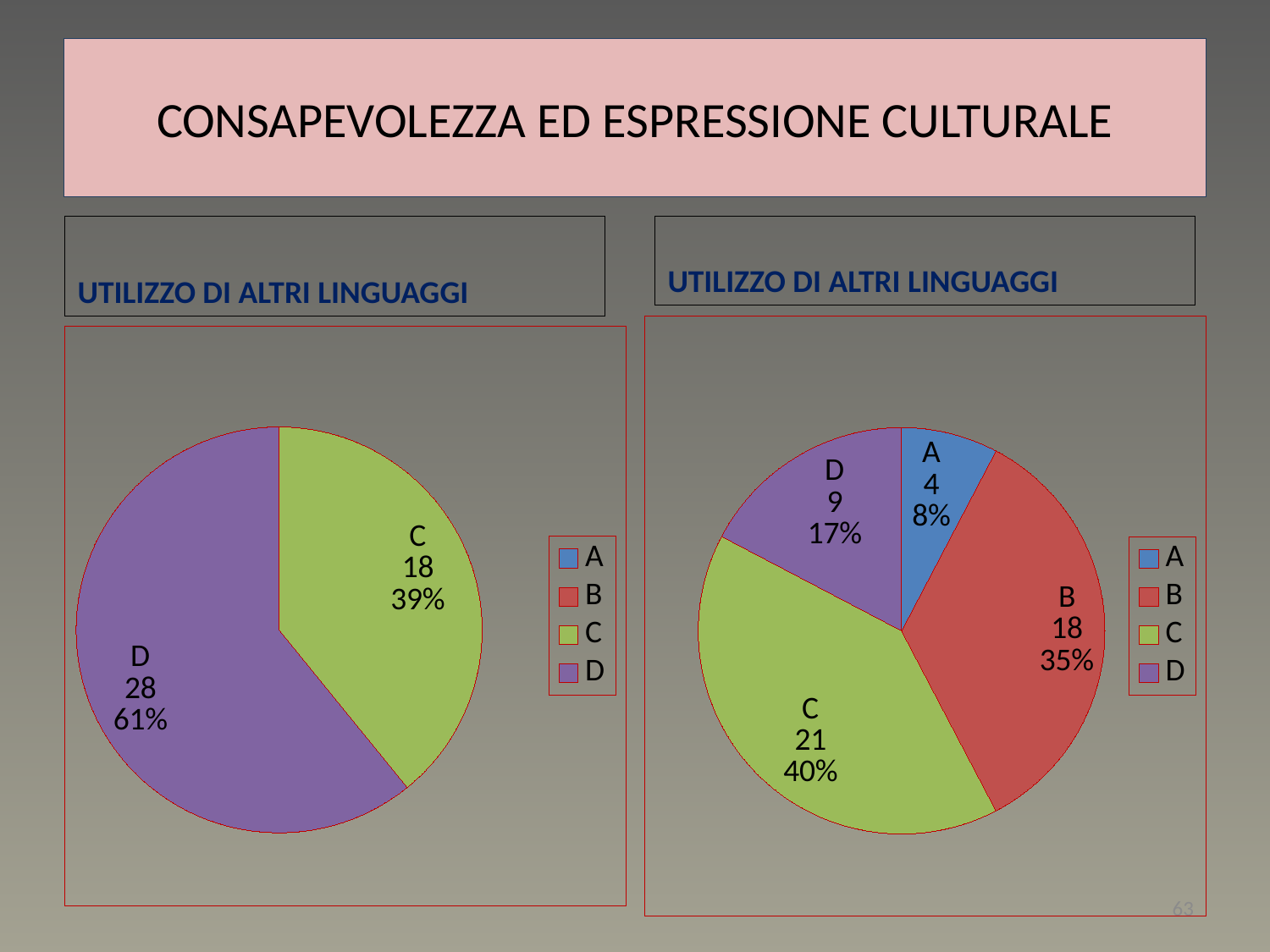
In the right pie chart, what share of the pie does category A have? 8% How many slices are shown in the left pie chart? 2 In the right pie chart, which category has the largest slice? C How many entries does the legend of the right chart list? 4 In the right pie chart, which category has the smallest slice? A In the left pie chart, what is the value for category D? 28 In the left pie chart, what share of the pie does category C have? 39% In the right pie chart, what is the difference between the values for C and D? 12 What type of chart is the chart on the left? Pie chart In the left pie chart, which is larger, the value for C or the value for D? D How many slices are shown in the right pie chart? 4 In the right pie chart, what is the value for category B? 18